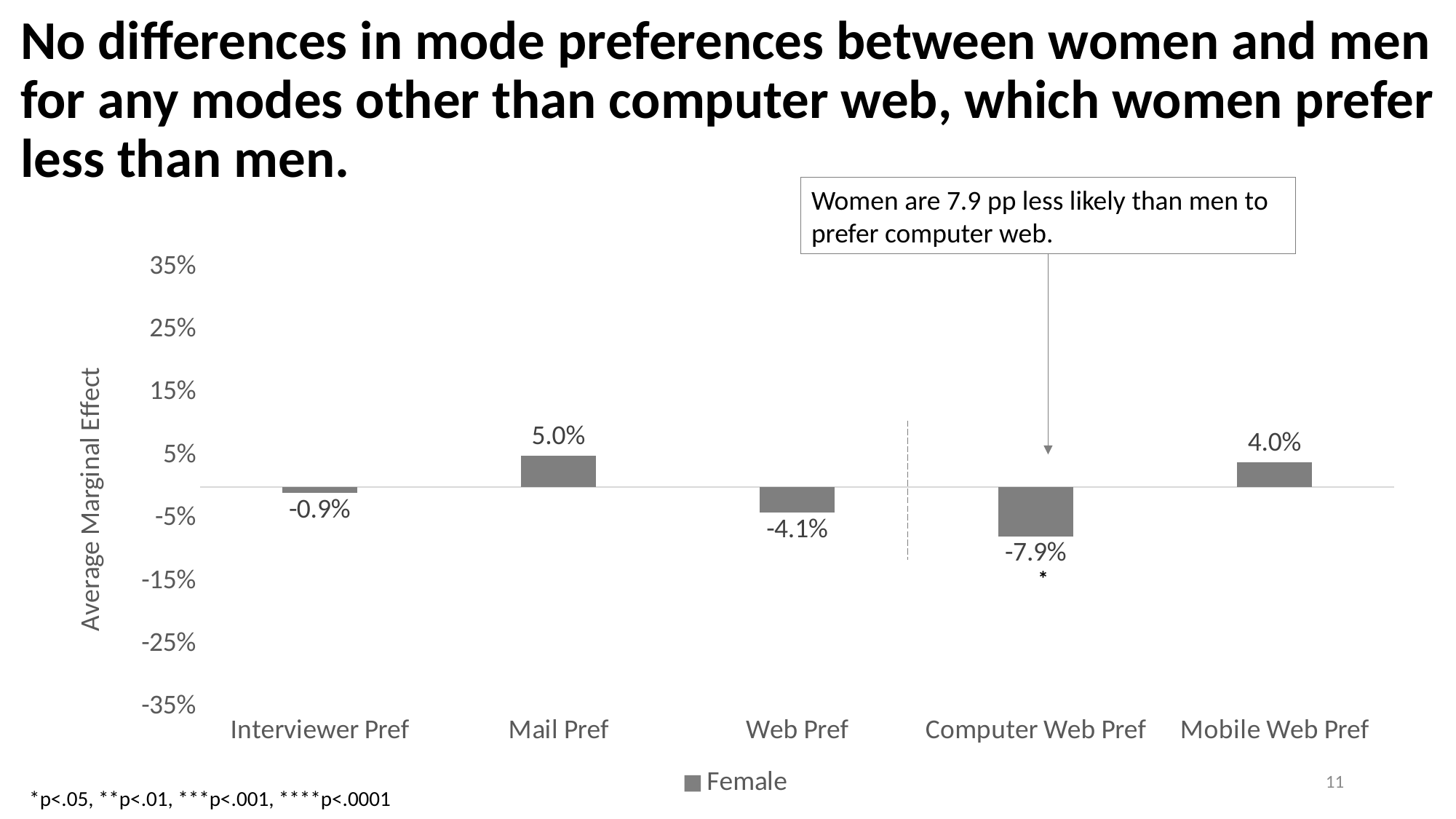
What kind of chart is shown on the slide? bar chart Is the value for Computer Web Pref greater or less than -5%? less Which category has the highest average marginal effect? Mail Pref Which is larger, the value for Web Pref or the value for Computer Web Pref? Web Pref How many categories are shown on the x axis? 5 What is the average marginal effect for Interviewer Pref? -0.9% What is the average marginal effect for Computer Web Pref? -7.9% How many series does the legend list? 1 What is the difference between the values for Mail Pref and Mobile Web Pref? 1.0% Which category has the lowest average marginal effect? Computer Web Pref What is the average marginal effect for Mail Pref? 5.0% What is the average marginal effect for Mobile Web Pref? 4.0%